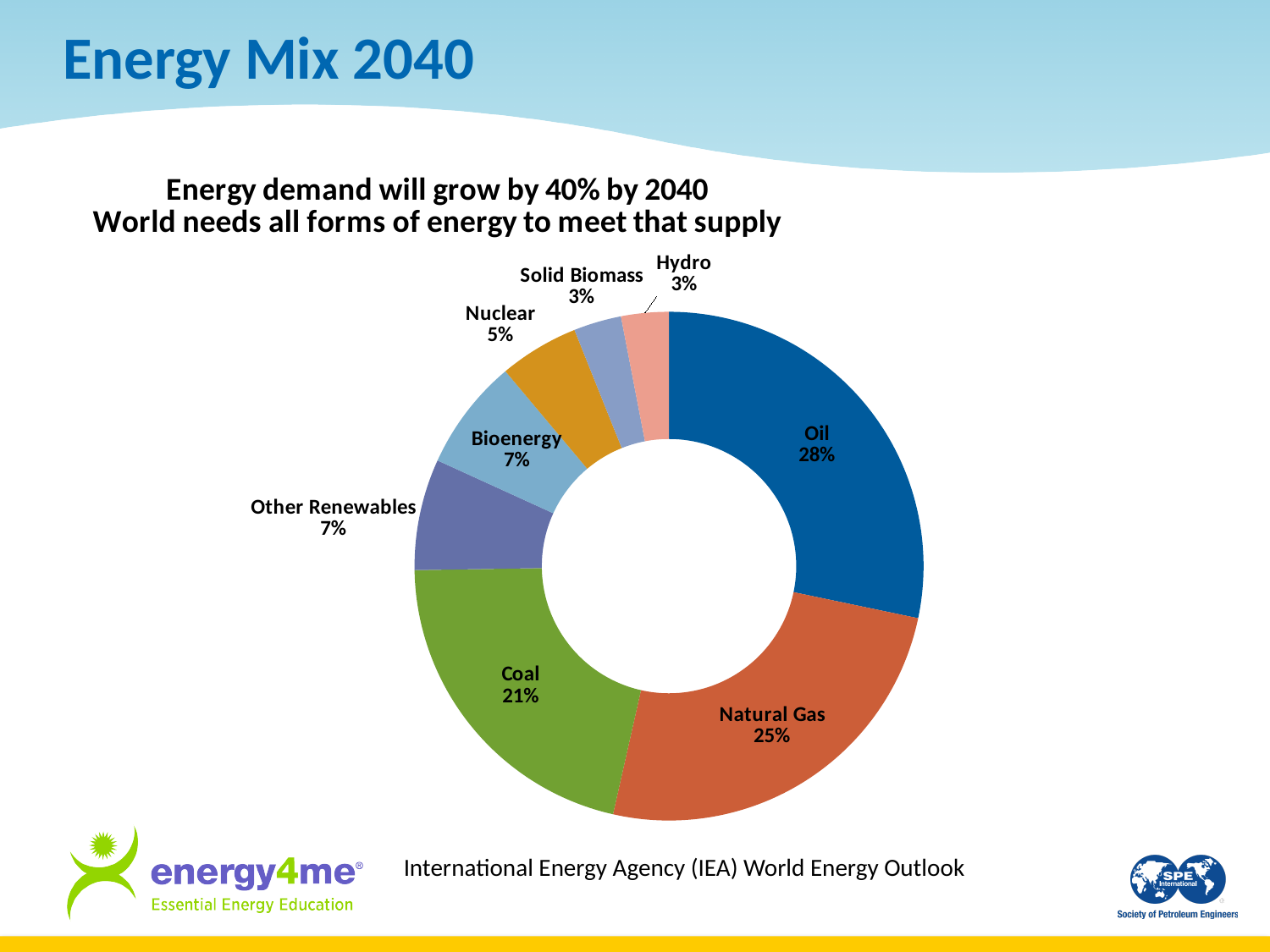
What is the difference in share between Natural Gas and Nuclear? 20% What share of the energy mix does Coal have? 21% What share of the energy mix does Oil have? 28% Which energy source has the largest share of the energy mix? Oil What share of the energy mix does Hydro have? 3% What is the title of the slide containing the chart? Energy Mix 2040 What share of the energy mix does Nuclear have? 5% Which has a larger share, Coal or Natural Gas? Natural Gas How many energy sources are shown in the chart? 8 What share of the energy mix does Natural Gas have? 25% What kind of chart is shown on the slide? Pie chart (doughnut) What is the difference in share between Oil and Coal? 7%